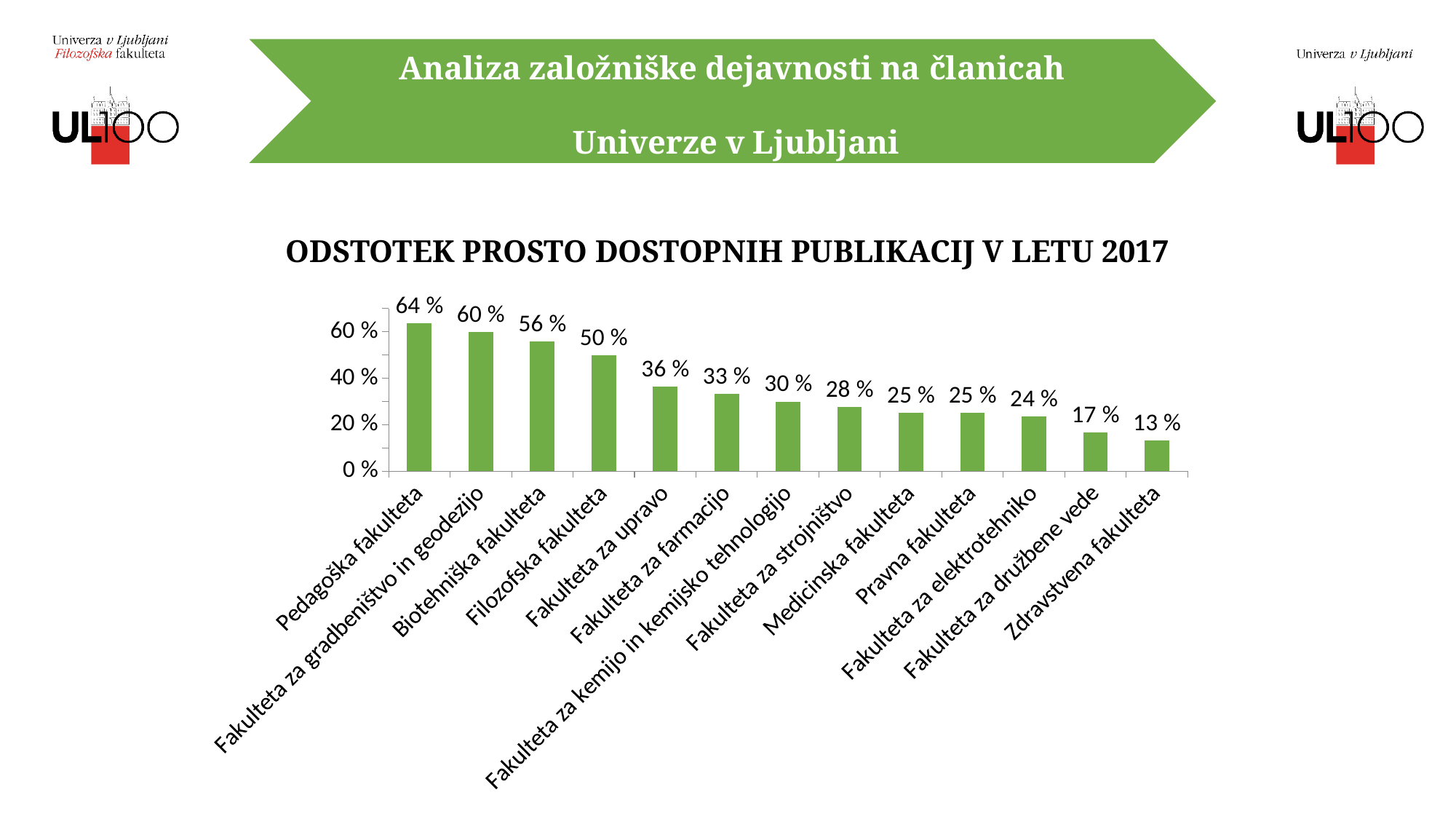
Is the value for Fakulteta za družbene vede greater or less than 20 %? less How many faculties are shown on the chart? 13 What is the value for Fakulteta za elektrotehniko? 24 % What kind of chart is shown on the slide? bar chart What is the value for Pedagoška fakulteta? 64 % Which faculty has the lowest percentage of open-access publications? Zdravstvena fakulteta What is the value for Filozofska fakulteta? 50 % What is the title of the chart? ODSTOTEK PROSTO DOSTOPNIH PUBLIKACIJ V LETU 2017 Which is larger, the value for Fakulteta za farmacijo or the value for Fakulteta za strojništvo? Fakulteta za farmacijo Do the values rise or fall from left to right along the x axis? fall Which faculty has the highest percentage of open-access publications? Pedagoška fakulteta What is the difference between the values for Biotehniška fakulteta and Fakulteta za upravo? 20 %